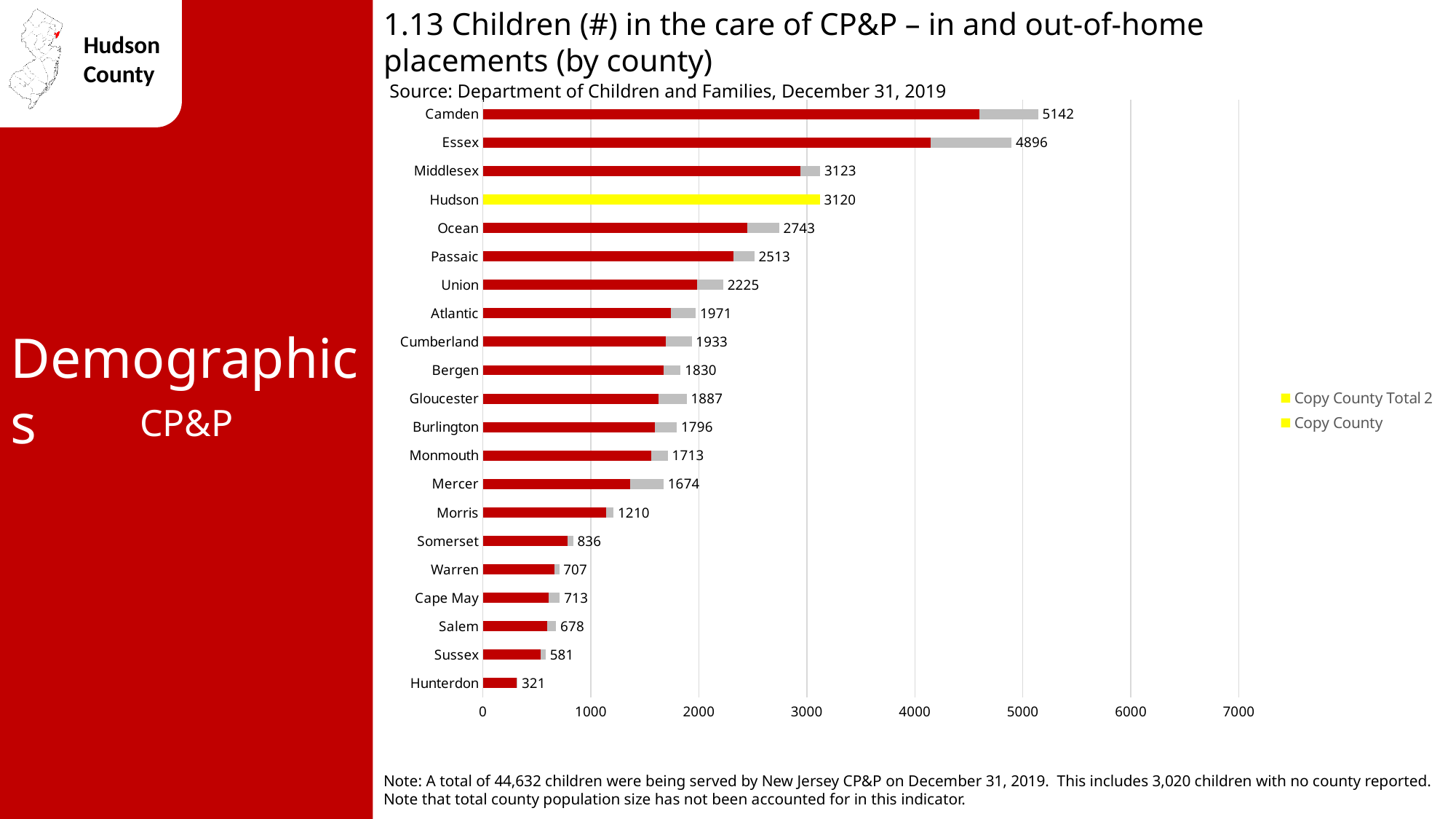
What is the total value shown for Camden? 5142 How many counties are shown on the chart? 21 Which county's bar is highlighted in yellow? Hudson Which county has the lowest total number of children in the care of CP&P? Hunterdon What kind of chart is shown on the slide? Bar chart How many entries does the legend list? 2 Is the total for Union greater or less than 2000? greater Which county has a larger total, Ocean or Passaic? Ocean What is the difference between the totals for Camden and Essex? 246 What is the total value shown for Hunterdon? 321 What is the total number of children in the care of CP&P for Hudson County? 3120 Which county has the highest total number of children in the care of CP&P? Camden